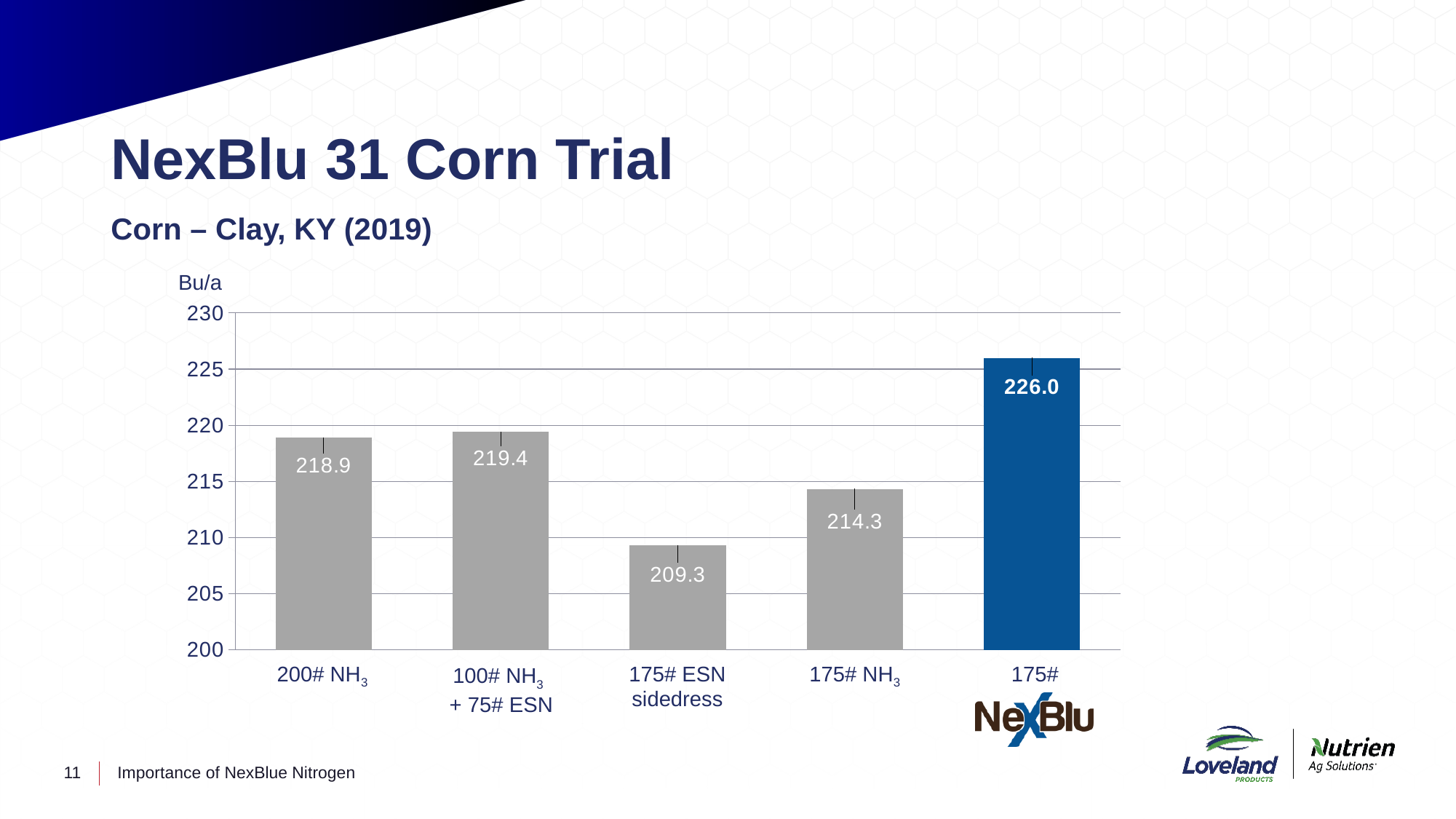
What kind of chart is shown on the slide? Bar chart Is the yield for 175# NH3 greater or less than 215? less What is the yield (Bu/a) for the 175# ESN sidedress treatment? 209.3 What is the yield (Bu/a) for the 100# NH3 + 75# ESN treatment? 219.4 Which treatment has the highest yield? 175# NexBlu What is the yield (Bu/a) for the 200# NH3 treatment? 218.9 What is the yield (Bu/a) for the 175# NexBlu treatment? 226.0 Which treatment has the lowest yield? 175# ESN sidedress How many treatments are shown in the chart? 5 Which has a higher yield, 175# NH3 or 175# ESN sidedress? 175# NH3 What unit is shown on the y axis of the chart? Bu/a What is the difference in yield between the 175# NexBlu treatment and the 175# NH3 treatment? 11.7